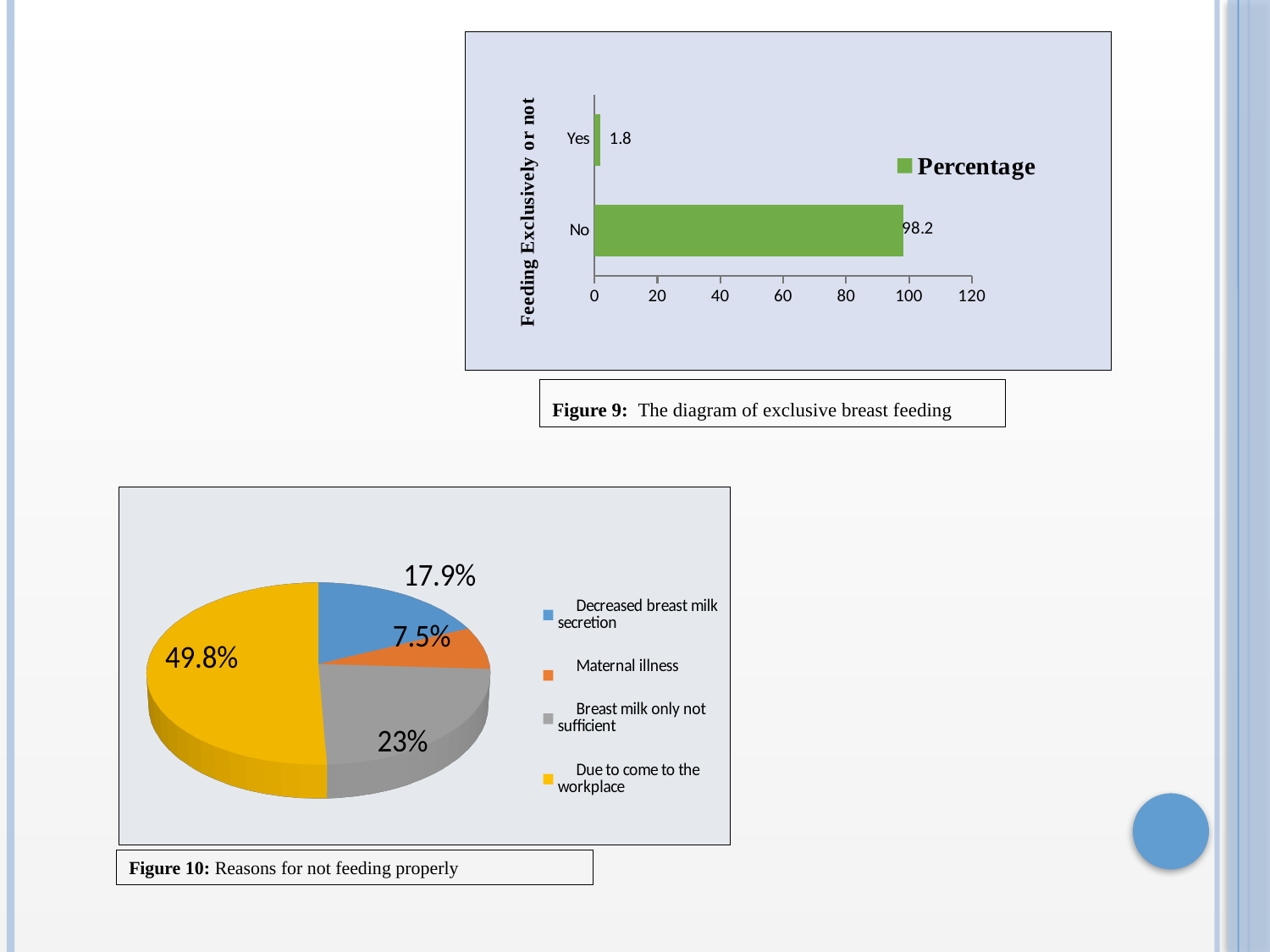
In the Figure 10 pie chart, what share is Maternal illness? 7.5% In the Figure 9 bar chart, what kind of chart is shown? Bar chart In the Figure 10 pie chart, which reason has the smallest share? Maternal illness In the Figure 9 bar chart, how many series does the legend list? 1 In the Figure 10 pie chart, how many categories are shown? 4 In the Figure 9 bar chart, what is the difference between the values for No and Yes? 96.4 In the Figure 10 pie chart, which is larger: Decreased breast milk secretion or Breast milk only not sufficient? Breast milk only not sufficient In the Figure 10 pie chart, what share is Due to come to the workplace? 49.8% In the Figure 9 bar chart, what is the value for Yes? 1.8 In the Figure 9 bar chart, what is the value for No? 98.2 In the Figure 9 bar chart, what is the label on the vertical axis? Feeding Exclusively or not In the Figure 9 bar chart, which category has the higher value? No